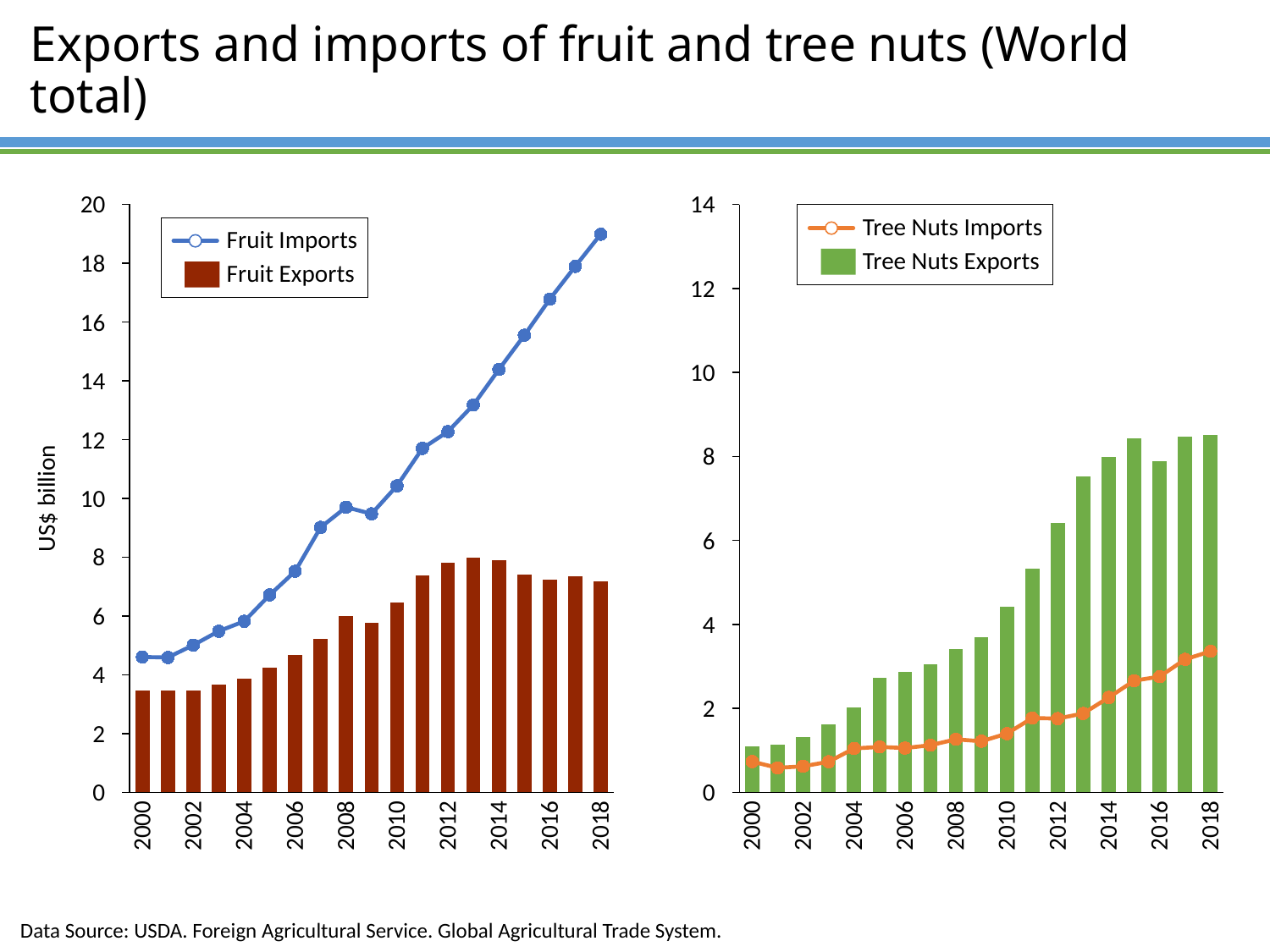
On the left chart, is the value for Fruit Exports in 2013 greater or less than 6? greater On the left chart, how many series does the legend list? 2 On the right chart, how many years are shown on the x axis? 10 On the left chart, is the value for Fruit Imports in 2000 greater or less than 6? less On the right chart, is the value for Tree Nuts Exports in 2000 greater or less than 2? less On the left chart, which is larger in 2018: Fruit Imports or Fruit Exports? Fruit Imports On the left chart, do Fruit Imports generally rise or fall from 2000 to 2018? rise What is the y-axis label on the left chart? US$ billion On the left chart, in which year are Fruit Imports highest? 2018 On the right chart, which is larger in 2018: Tree Nuts Exports or Tree Nuts Imports? Tree Nuts Exports